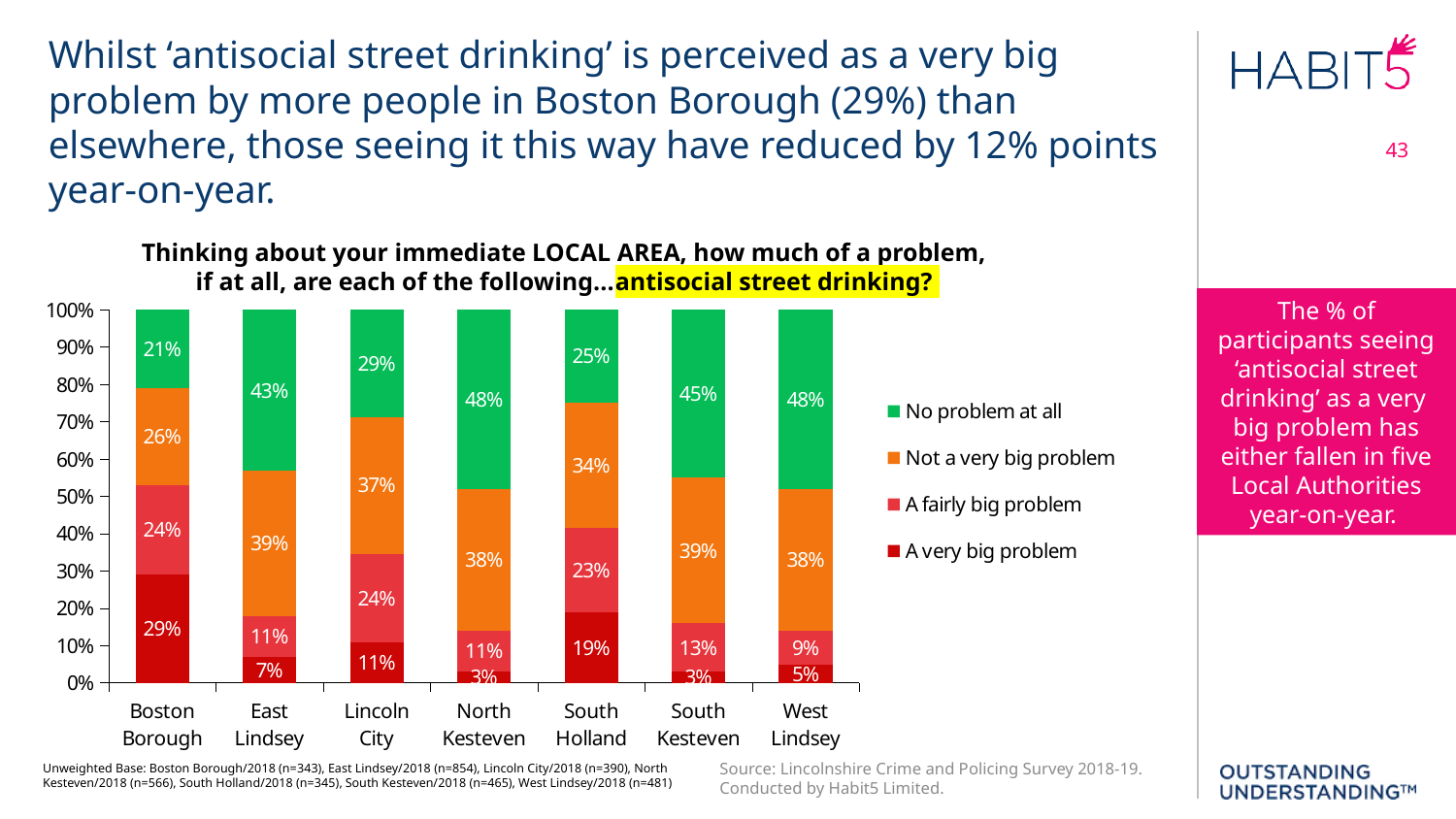
How many series does the chart legend list? 4 Which has a larger 'A very big problem' share, East Lindsey or Lincoln City? Lincoln City Which local authority has the lowest 'No problem at all' share? Boston Borough What is the 'A fairly big problem' value for Lincoln City? 24% What percentage of South Holland participants say antisocial street drinking is 'Not a very big problem'? 34% Which legend entry is shown in green? No problem at all What is the 'No problem at all' value for North Kesteven? 48% Which local authority has the highest share of participants seeing antisocial street drinking as a very big problem? Boston Borough What is the difference in percentage points between the 'A very big problem' values for Boston Borough and South Holland? 10 percentage points What percentage of Boston Borough participants see antisocial street drinking as a very big problem? 29% What type of chart is shown on the slide? Stacked bar chart How many local authorities are shown on the x axis of the chart? 7